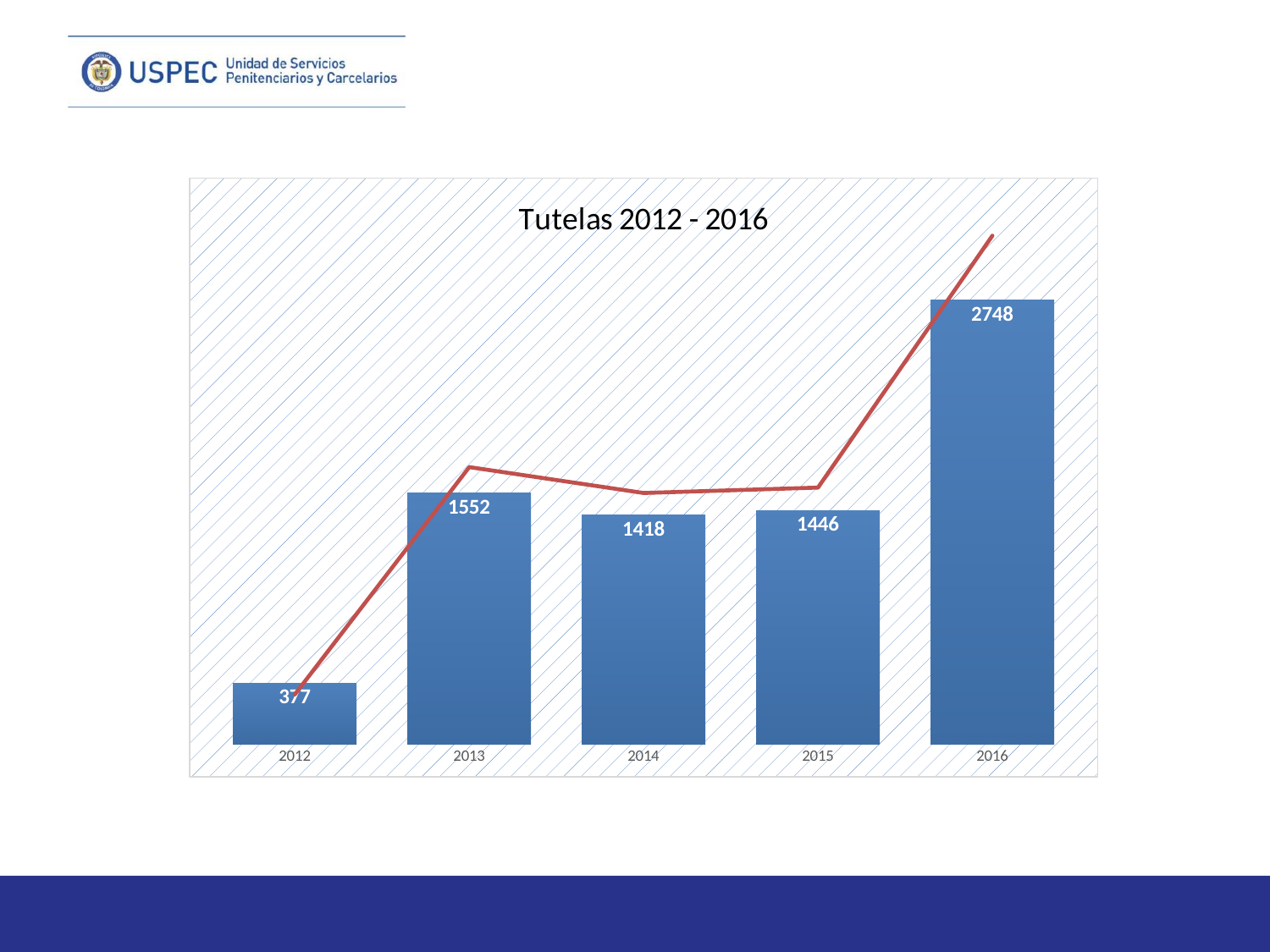
What is the value for 2014? 1418 What is the value for 2013? 1552 What is the value for 2012? 377 How many years are shown on the x axis? 5 Which is larger, the value for 2013 or the value for 2014? 2013 What kind of chart is this? Bar chart with a line overlay What is the value for 2015? 1446 What is the value for 2016? 2748 What is the difference between the values for 2016 and 2015? 1302 What is the title of the chart? Tutelas 2012 - 2016 Which year has the highest value? 2016 Which year has the lowest value? 2012